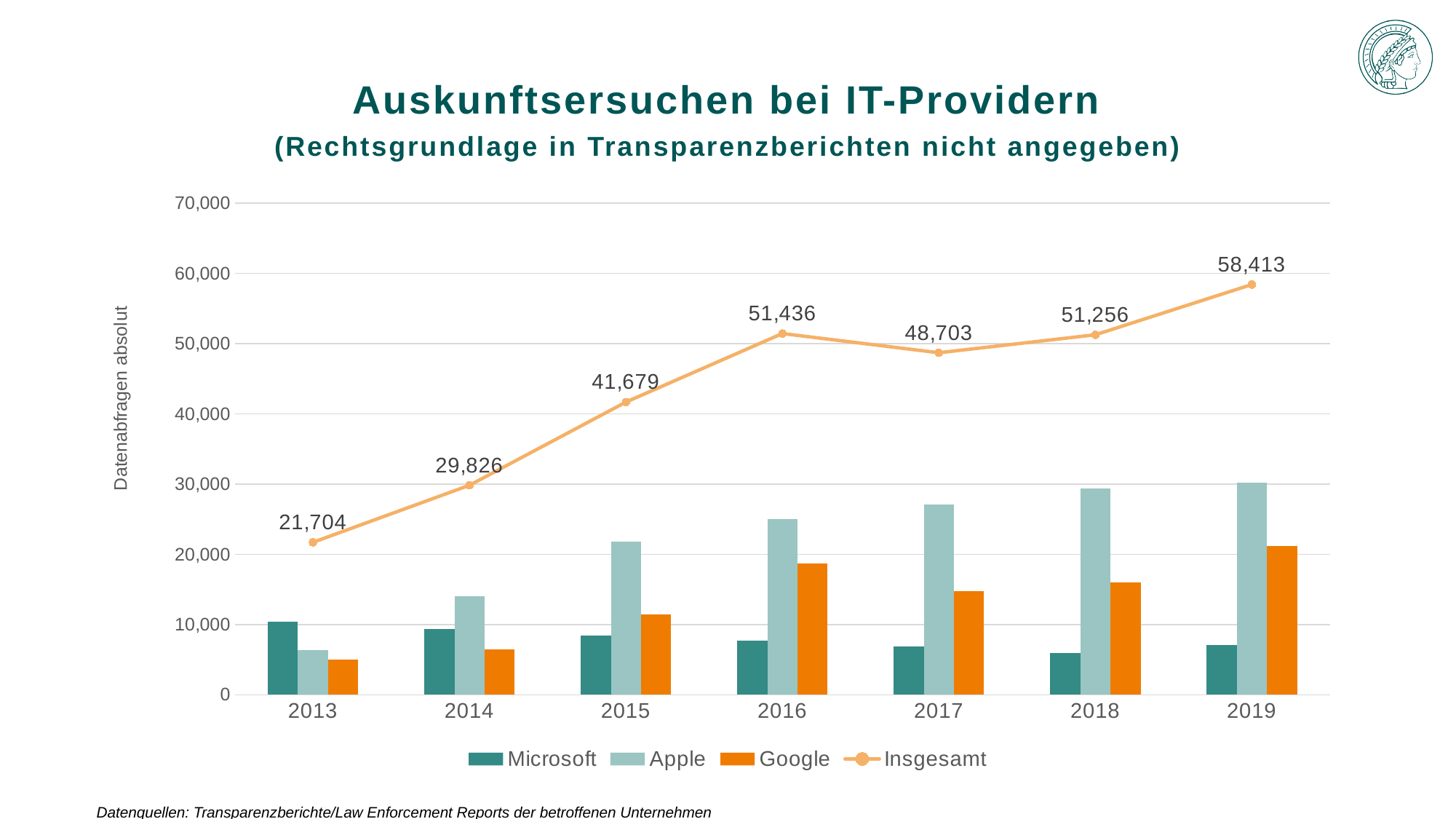
How many series does the legend list? 4 What is the value of Insgesamt in 2019? 58,413 In which year is the Insgesamt value highest? 2019 How many years are shown on the x axis? 7 Is the value for Microsoft in 2018 greater or less than 10,000? less Is the value for Google in 2016 greater or less than 20,000? less Which is larger, the Insgesamt value for 2016 or for 2018? 2016 What kind of chart is shown on the slide? Combined bar and line chart What is the difference between the Insgesamt values for 2016 and 2017? 2,733 What is the value of Insgesamt in 2013? 21,704 In which year is the Insgesamt value lowest? 2013 What is the value of Insgesamt in 2017? 48,703